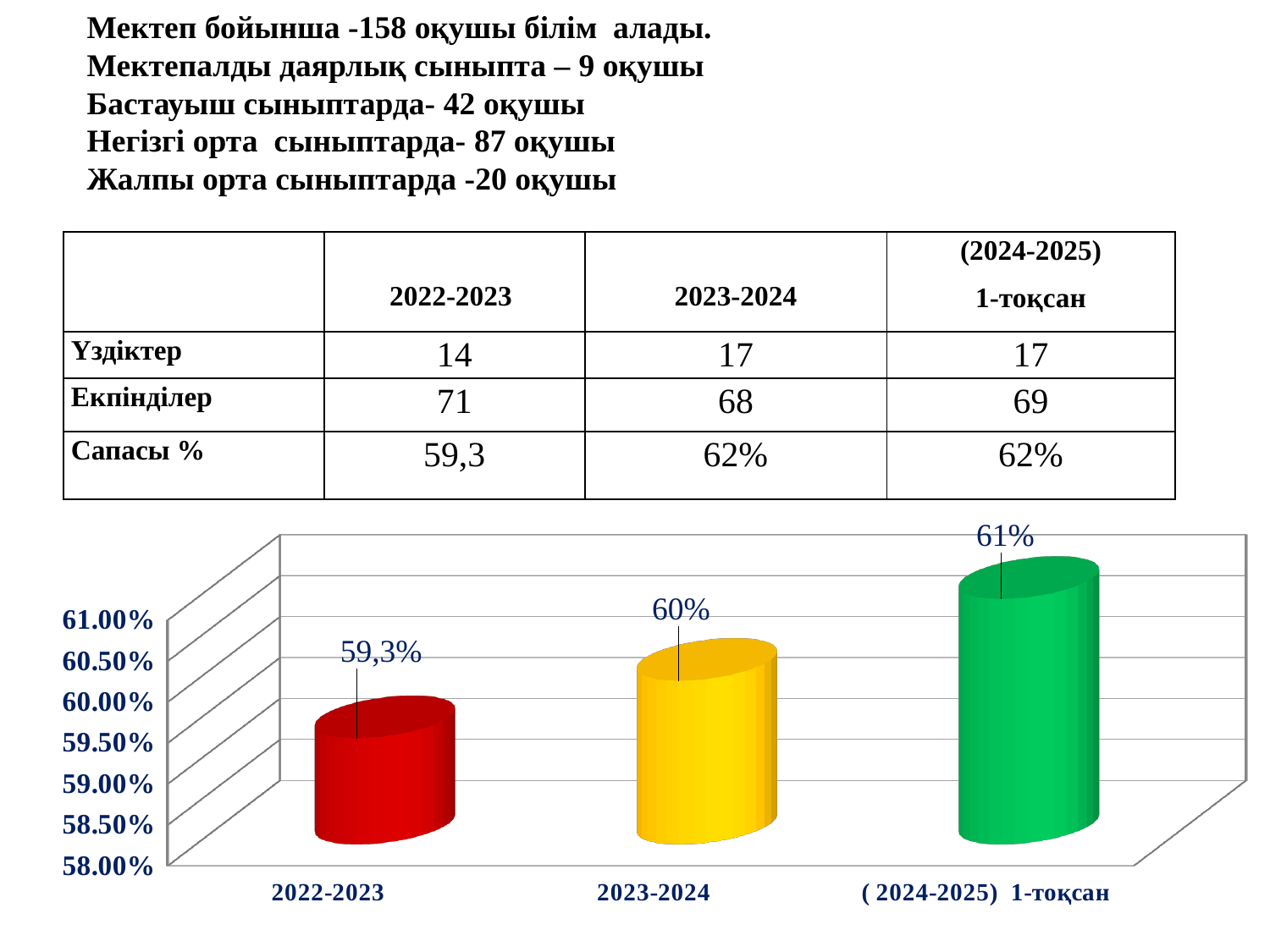
What is the value for 2023-2024? 60% Which category has the lowest value? 2022-2023 Is the value for 2022-2023 greater or less than 59.50%? less Do the values rise or fall from 2022-2023 to ( 2024-2025) 1-тоқсан? rise What is the value for 2022-2023? 59,3% What colour is the bar for 2023-2024? yellow How many categories are shown on the x axis? 3 What is the difference between the values for ( 2024-2025) 1-тоқсан and 2023-2024? 1% Which is larger, the value for 2023-2024 or the value for 2022-2023? 2023-2024 What is the value for ( 2024-2025) 1-тоқсан? 61% What kind of chart is shown on the slide? bar chart Which category has the highest value? ( 2024-2025) 1-тоқсан